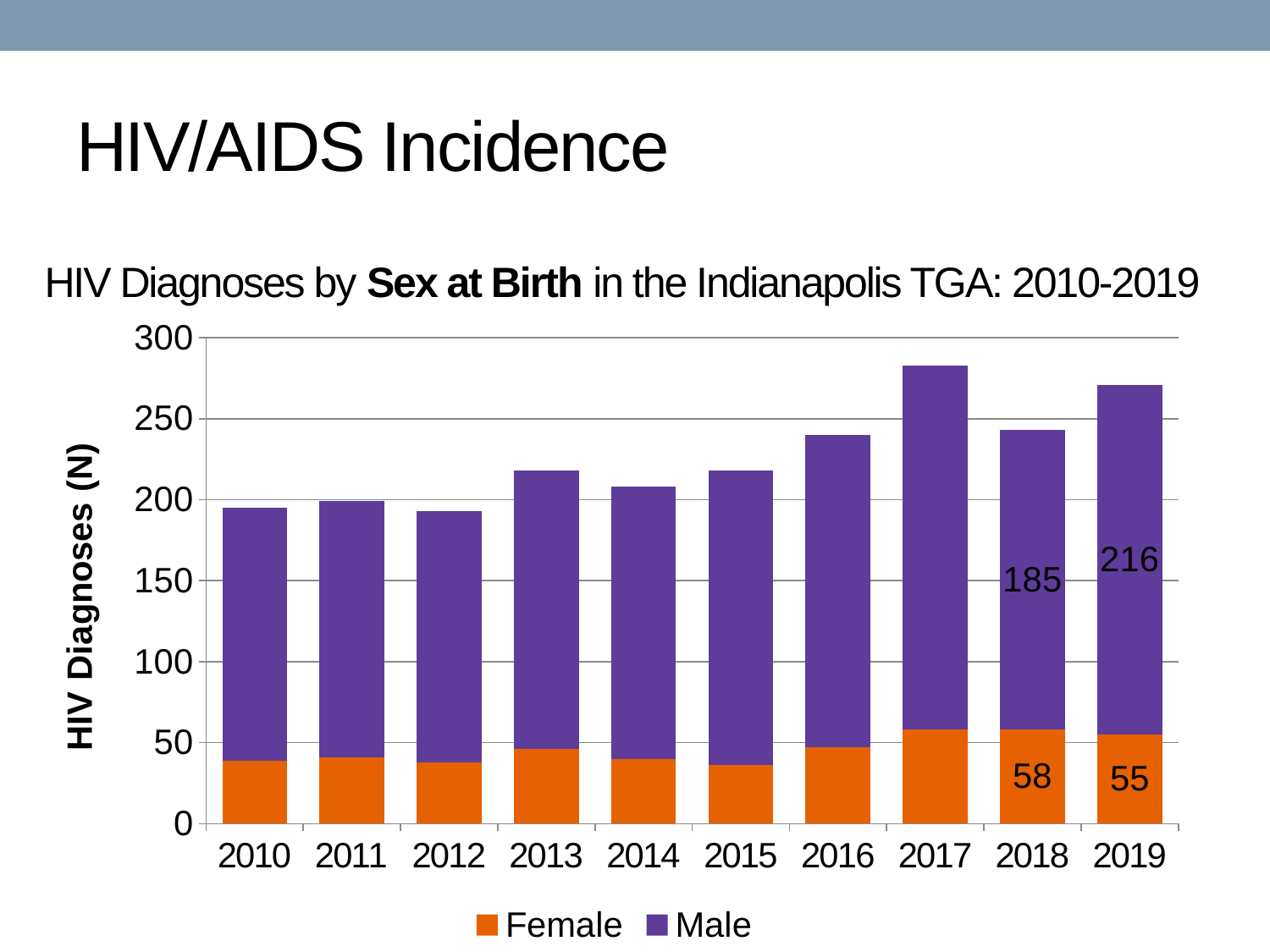
Which year has the tallest stacked bar overall? 2017 How many years are shown on the x axis? 10 What is the value for Female in 2019? 55 What is the total of the stacked bar for 2018? 243 Is the total value for 2016 greater or less than 200? greater What is the value for Male in 2019? 216 Which is larger, the Female value in 2018 or the Female value in 2019? 2018 How many series does the legend list? 2 Is the total value for 2010 greater or less than 200? less What is the total of the stacked bar for 2019? 271 What is the difference between the Male value in 2019 and the Male value in 2018? 31 What is the value for Male in 2018? 185